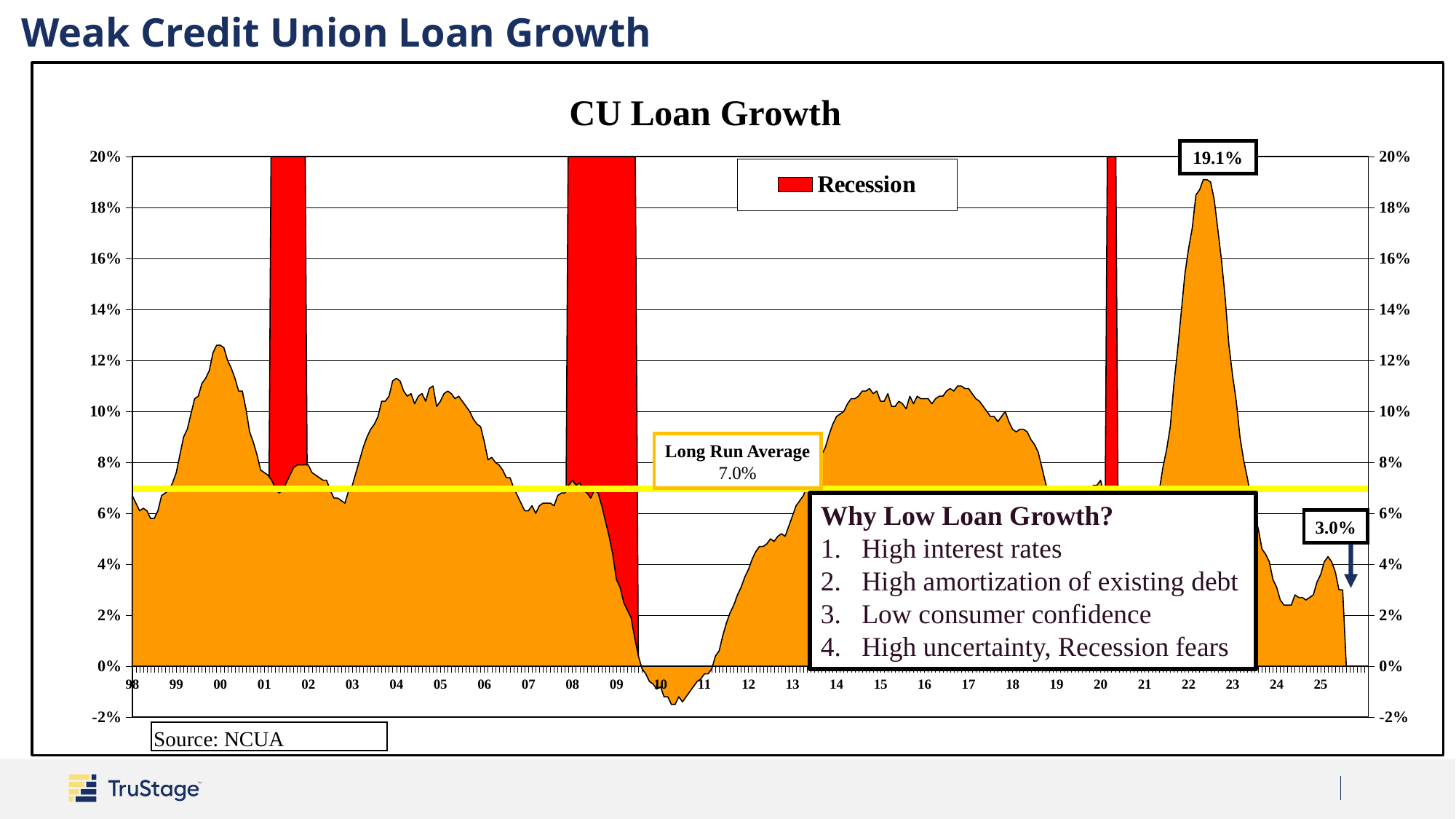
What is the title of the chart? CU Loan Growth How much higher is the labeled 19.1% peak than the Long Run Average of 7.0%? 12.1% Which is larger: the loan growth peak around 2022 or the peak around 2000? The peak around 2022 What is the Long Run Average value shown on the chart? 7.0% How many recession periods are shaded on the chart? 3 What is the difference between the labeled 2022 peak of 19.1% and the labeled 2025 value of 3.0%? 16.1% What is the most recent value labeled on the chart in 2025? 3.0% What kind of chart is shown on the slide? Area chart Does loan growth rise or fall from the 2022 peak to 2025? Fall What is the peak value labeled on the chart around 2022? 19.1% Is the loan growth value at the trough around 2010 greater or less than 0%? less Is the loan growth value in 2016 greater or less than 8%? greater